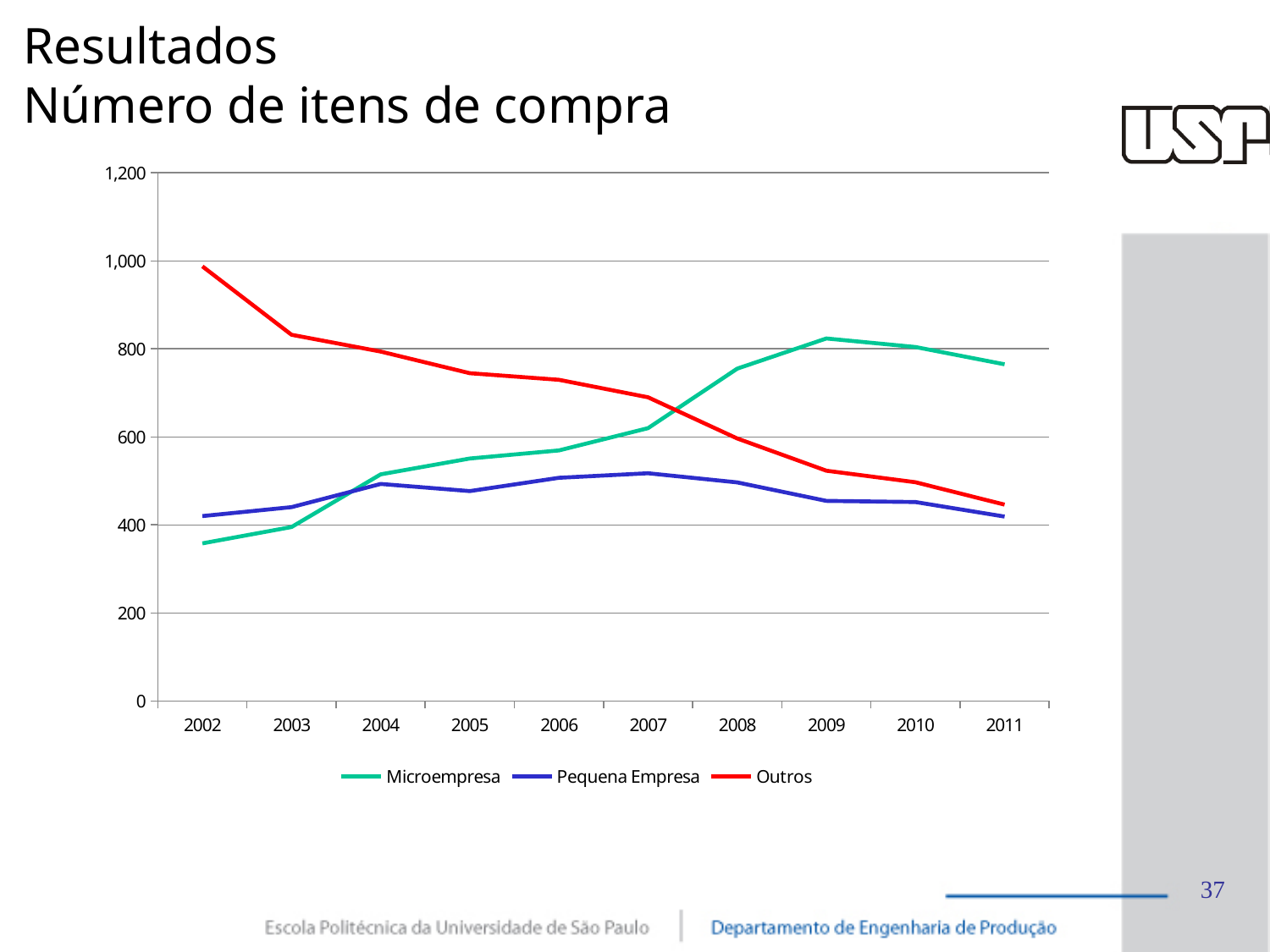
Is the value for Outros in 2002 greater or less than 800? greater Is the value for Pequena Empresa in 2007 greater or less than 600? less In 2011, which series has the larger value, Microempresa or Outros? Microempresa What kind of chart is shown on the slide? Line chart In which year does the Microempresa series reach its highest value? 2009 Is the value for Microempresa in 2002 greater or less than 400? less Which series is drawn in red? Outros How many series does the legend list? 3 In 2002, which series has the larger value, Outros or Microempresa? Outros In which year does the Outros series reach its lowest value? 2011 Does the Outros series generally rise or fall from 2002 to 2011? Fall How many years are shown on the x axis? 10